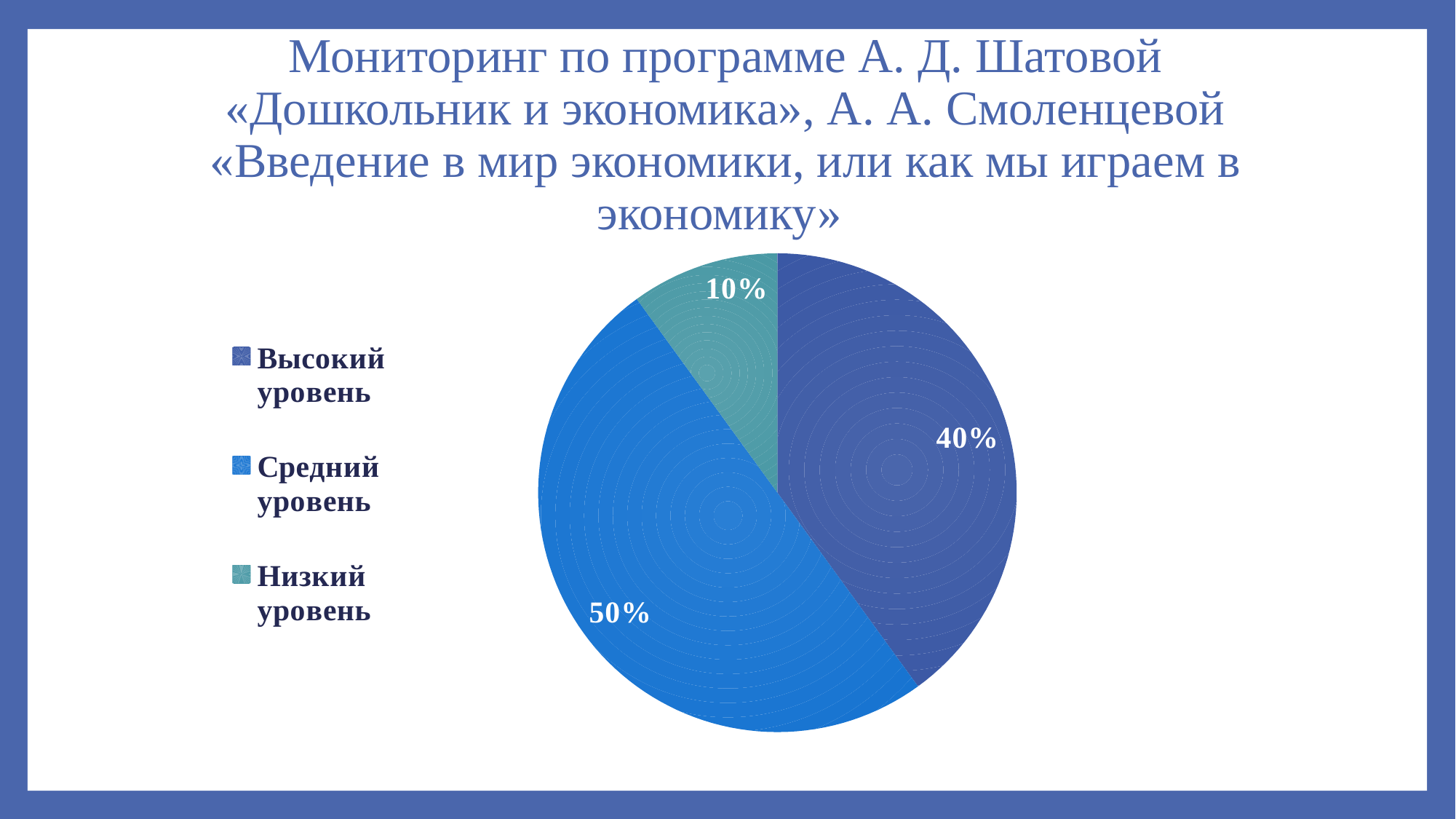
What is the value for Высокий уровень? 40% Which is larger, the value for Высокий уровень or the value for Низкий уровень? Высокий уровень How many entries does the legend list? 3 Which category has the largest share of the pie? Средний уровень What is the value for Низкий уровень? 10% What is the difference between the values for Высокий уровень and Низкий уровень? 30% How many categories does the pie chart have? 3 Which category has the smallest share of the pie? Низкий уровень What colour is the slice for Низкий уровень? teal What type of chart is shown on the slide? pie chart What is the difference between the values for Средний уровень and Высокий уровень? 10% What is the value for Средний уровень? 50%